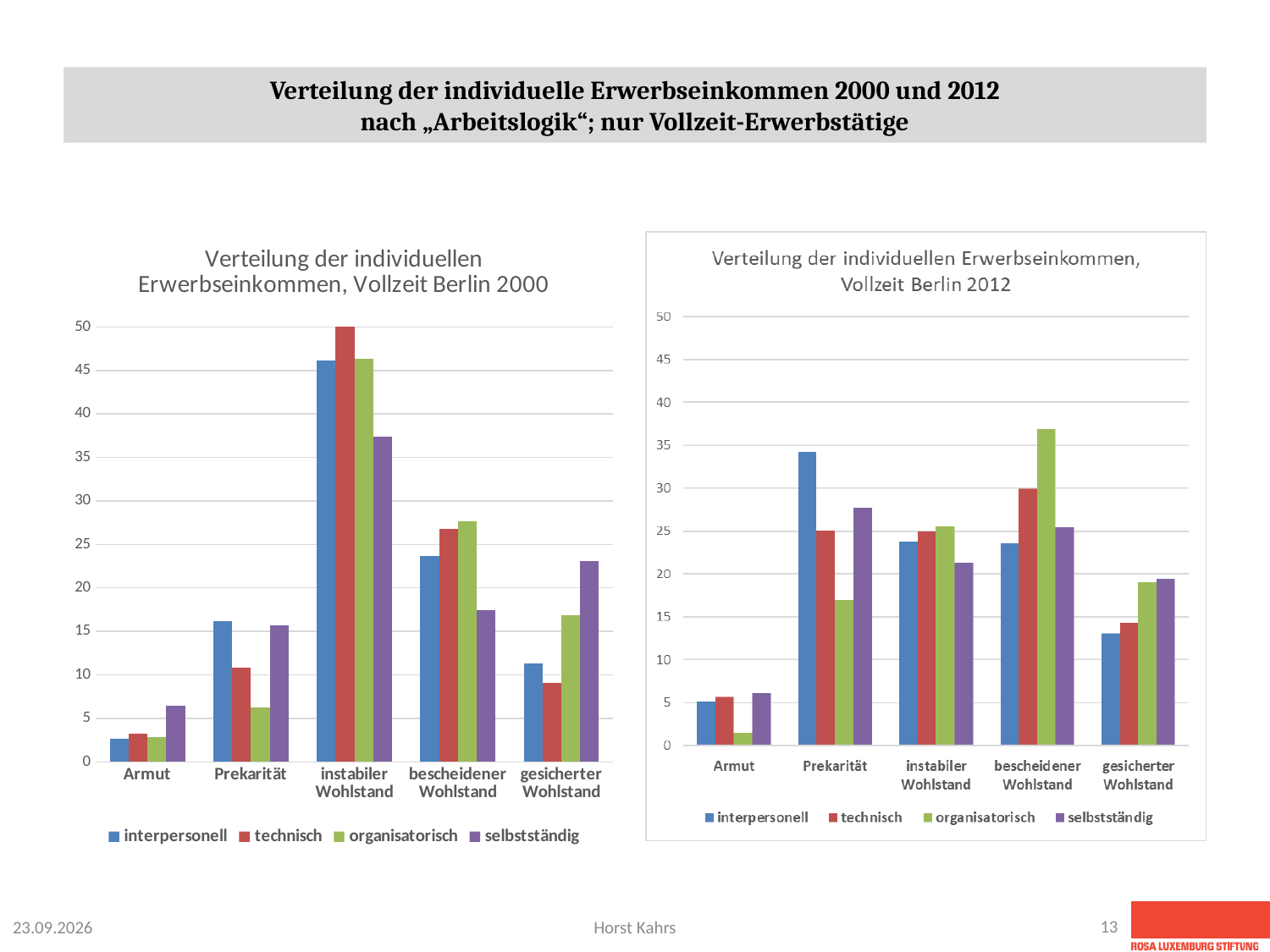
In the left chart (Vollzeit Berlin 2000), which category has the highest 'technisch' bar? instabiler Wohlstand In the right chart (Vollzeit Berlin 2012), for Prekarität, which is larger: 'interpersonell' or 'technisch'? interpersonell In the left chart (Vollzeit Berlin 2000), how many categories are shown on the x axis? 5 In the right chart (Vollzeit Berlin 2012), how many series does the legend list? 4 In the left chart (Vollzeit Berlin 2000), is the 'technisch' value for instabiler Wohlstand greater or less than 45? greater In the right chart (Vollzeit Berlin 2012), which category has the highest 'interpersonell' bar? Prekarität What is the title of the right chart? Verteilung der individuellen Erwerbseinkommen, Vollzeit Berlin 2012 In the right chart (Vollzeit Berlin 2012), which series has the lowest bar for Armut? organisatorisch In the left chart (Vollzeit Berlin 2000), for gesicherter Wohlstand, which is larger: 'organisatorisch' or 'technisch'? organisatorisch In the left chart (Vollzeit Berlin 2000), is the 'selbstständig' value for gesicherter Wohlstand greater or less than 20? greater In the right chart (Vollzeit Berlin 2012), is the 'organisatorisch' value for bescheidener Wohlstand greater or less than 35? greater What kind of chart is the left chart, 'Verteilung der individuellen Erwerbseinkommen, Vollzeit Berlin 2000'? bar chart